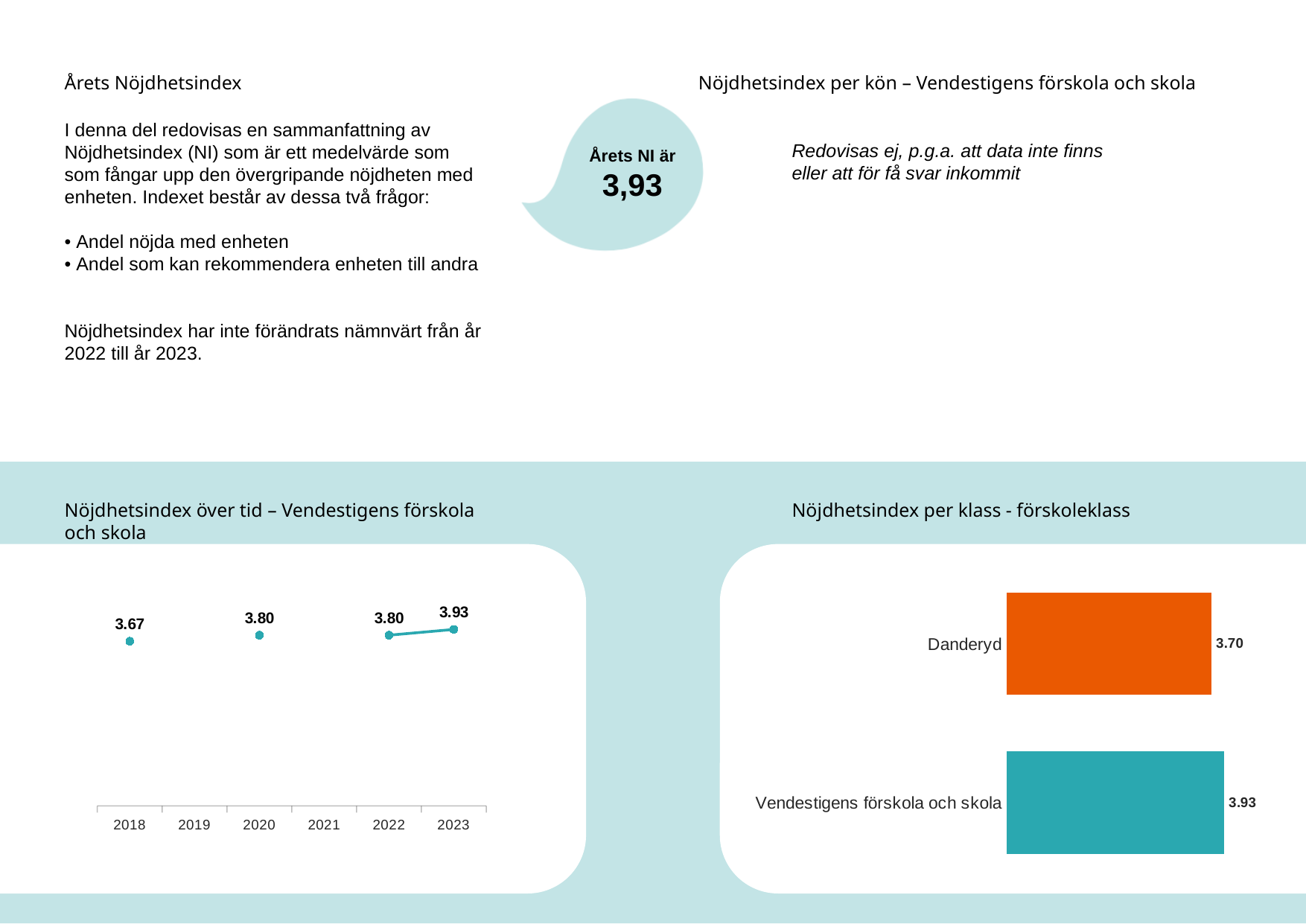
What kind of chart is 'Nöjdhetsindex per klass - förskoleklass'? bar chart In the chart 'Nöjdhetsindex över tid – Vendestigens förskola och skola', which year has the lowest value? 2018 In the chart 'Nöjdhetsindex per klass - förskoleklass', what is the value for Danderyd? 3.70 In the chart 'Nöjdhetsindex över tid – Vendestigens förskola och skola', how many years have a plotted data point? 4 In the chart 'Nöjdhetsindex över tid – Vendestigens förskola och skola', what is the value for 2020? 3.80 In the chart 'Nöjdhetsindex per klass - förskoleklass', which category has the higher value, Danderyd or Vendestigens förskola och skola? Vendestigens förskola och skola In the chart 'Nöjdhetsindex över tid – Vendestigens förskola och skola', what is the difference between the 2023 and 2022 values? 0.13 In the chart 'Nöjdhetsindex över tid – Vendestigens förskola och skola', what is the value for 2023? 3.93 In the chart 'Nöjdhetsindex över tid – Vendestigens förskola och skola', what is the value for 2018? 3.67 In the chart 'Nöjdhetsindex över tid – Vendestigens förskola och skola', which year has the highest value? 2023 In the chart 'Nöjdhetsindex över tid – Vendestigens förskola och skola', do the values rise or fall from 2018 to 2023? rise In the chart 'Nöjdhetsindex per klass - förskoleklass', what is the value for Vendestigens förskola och skola? 3.93